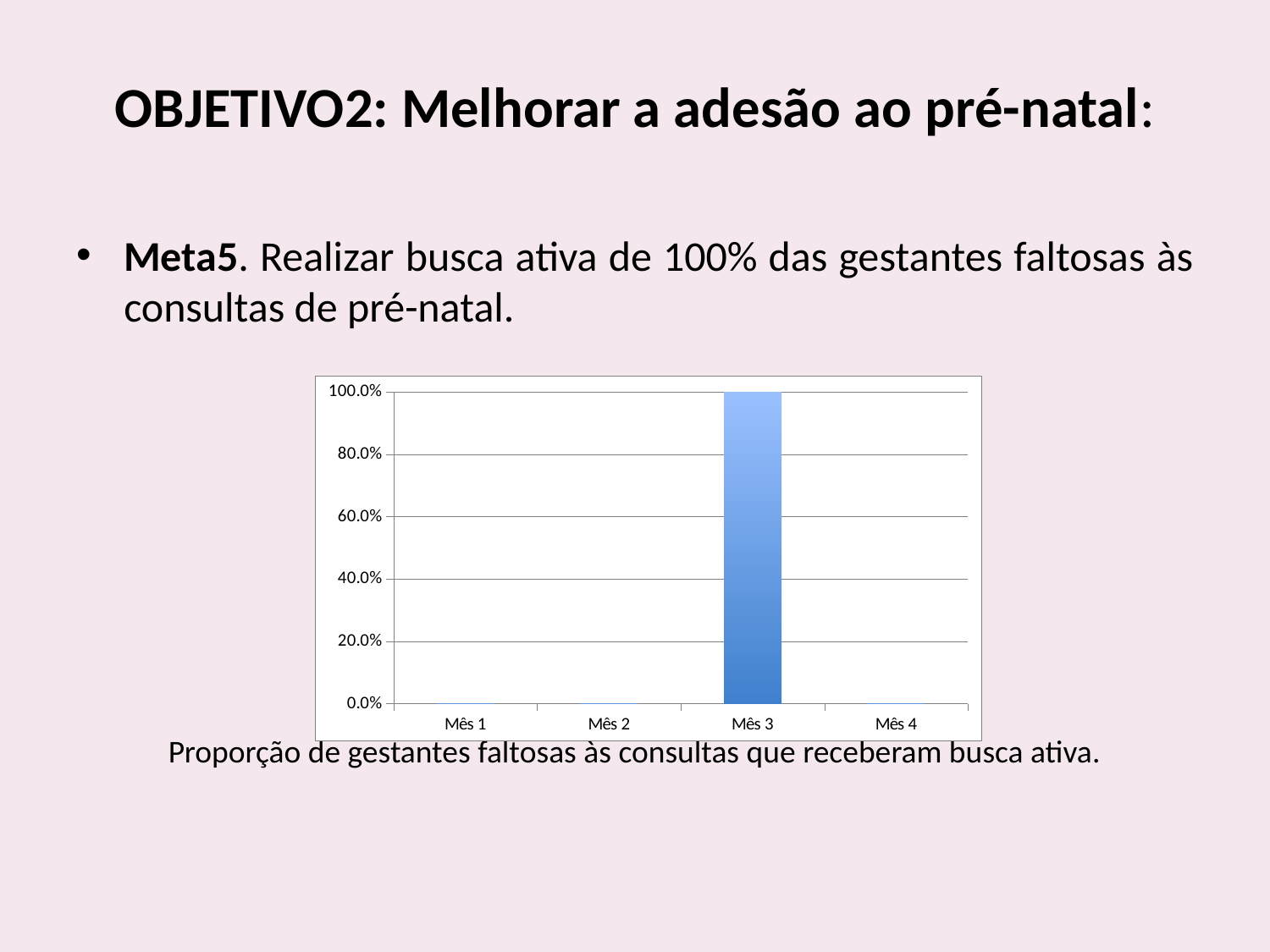
Which is larger, the value for Mês 1 or the value for Mês 3? Mês 3 Which month has the highest value in the chart? Mês 3 What caption appears below the chart? Proporção de gestantes faltosas às consultas que receberam busca ativa. What is the highest value shown on the y axis of the chart? 100.0% How many categories (months) are shown on the x axis of the chart? 4 Which is larger, the value for Mês 3 or the value for Mês 2? Mês 3 Is the value for Mês 1 greater or less than 20.0%? less What is the value for Mês 3 in the chart? 100.0% Is the value for Mês 2 greater or less than 20.0%? less Is the value for Mês 3 greater or less than 80.0%? greater What type of chart is shown on the slide? bar chart